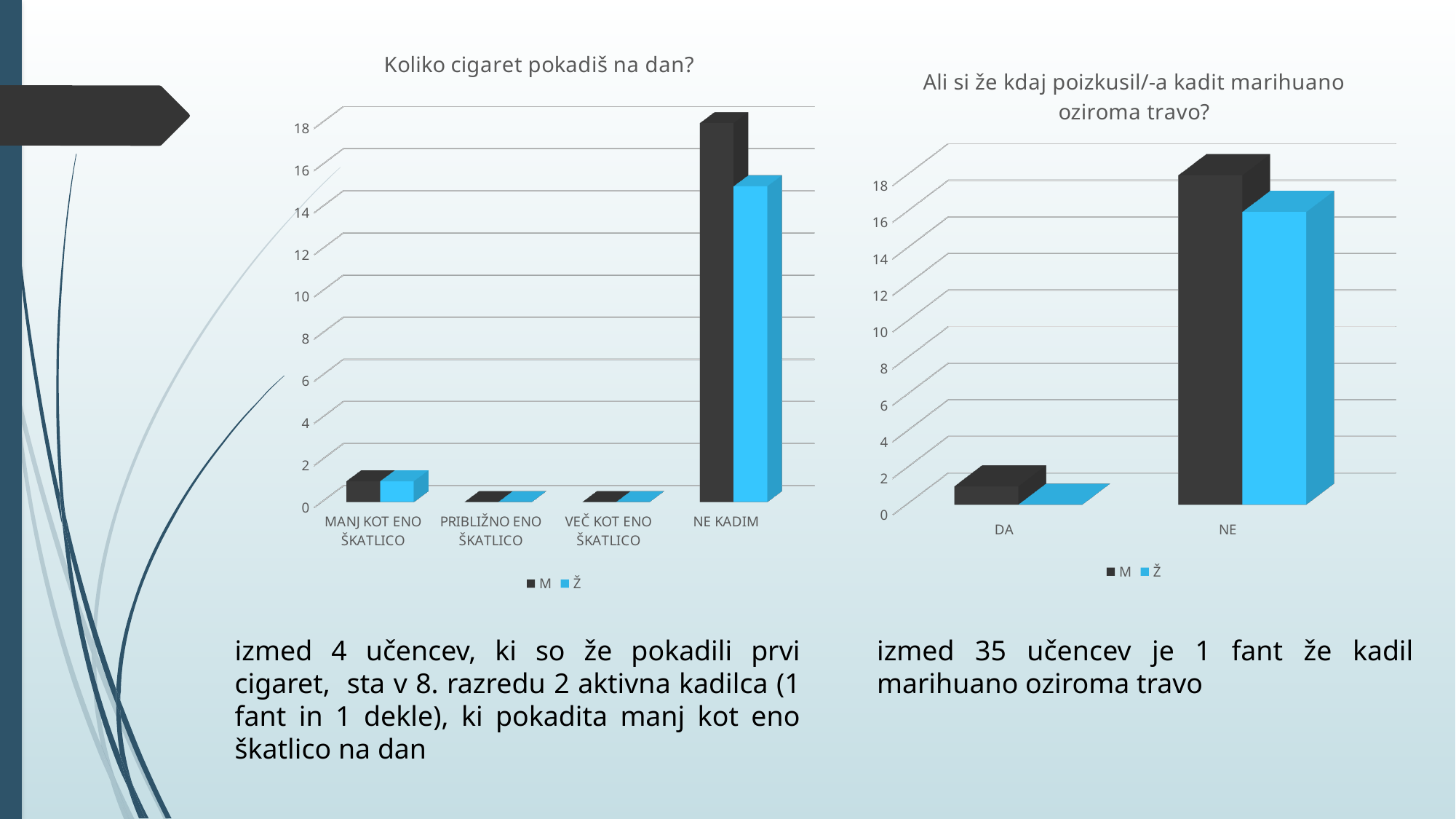
In the chart titled "Ali si že kdaj poizkusil/-a kadit marihuano oziroma travo?", which series has the larger value in the NE category, M or Ž? M In the chart titled "Koliko cigaret pokadiš na dan?", is the value for Ž in the MANJ KOT ENO ŠKATLICO category greater or less than 4? less In the chart titled "Ali si že kdaj poizkusil/-a kadit marihuano oziroma travo?", is the value for M in the NE category greater or less than 10? greater What kind of chart is the chart titled "Koliko cigaret pokadiš na dan?"? bar chart In the chart titled "Koliko cigaret pokadiš na dan?", which series has the larger value in the NE KADIM category, M or Ž? M In the chart titled "Koliko cigaret pokadiš na dan?", is the value for M in the NE KADIM category greater or less than 10? greater How many categories are shown on the x axis of the chart titled "Ali si že kdaj poizkusil/-a kadit marihuano oziroma travo?"? 2 What are the two legend entries in the chart titled "Ali si že kdaj poizkusil/-a kadit marihuano oziroma travo?"? M and Ž In the chart titled "Koliko cigaret pokadiš na dan?", which category has the highest value for series M? NE KADIM In the chart titled "Ali si že kdaj poizkusil/-a kadit marihuano oziroma travo?", which category has the highest value for series Ž? NE How many series does the legend list in the chart titled "Koliko cigaret pokadiš na dan?"? 2 How many categories are shown on the x axis of the chart titled "Koliko cigaret pokadiš na dan?"? 4